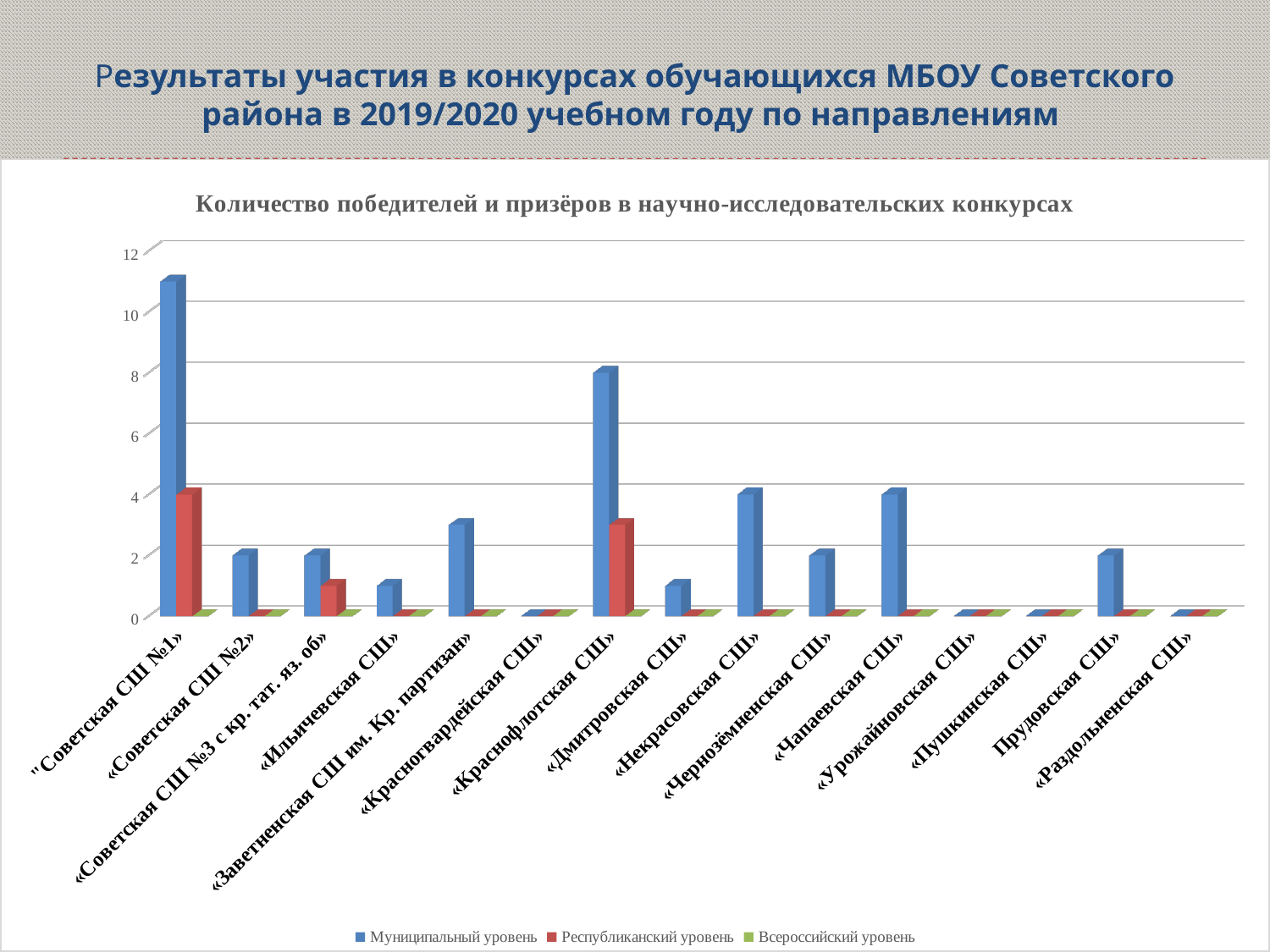
How many series does the legend list? 3 What is the title of the chart? Количество победителей и призёров в научно-исследовательских конкурсах Which is larger for Муниципальный уровень: «Некрасовская СШ» or «Дмитровская СШ»? «Некрасовская СШ» What kind of chart is shown on the slide? bar chart How many schools (categories) are shown on the x axis? 15 Is the Муниципальный уровень value for "Советская СШ №1" greater or less than 10? greater Is the Муниципальный уровень value for «Заветненская СШ им. Кр. партизан» greater or less than 4? less Which school has the highest value for Муниципальный уровень? "Советская СШ №1" Which is larger for Муниципальный уровень: "Советская СШ №1" or «Краснофлотская СШ»? "Советская СШ №1" Is the Республиканский уровень value for «Краснофлотская СШ» greater or less than 2? greater Which series is shown in green in the legend? Всероссийский уровень